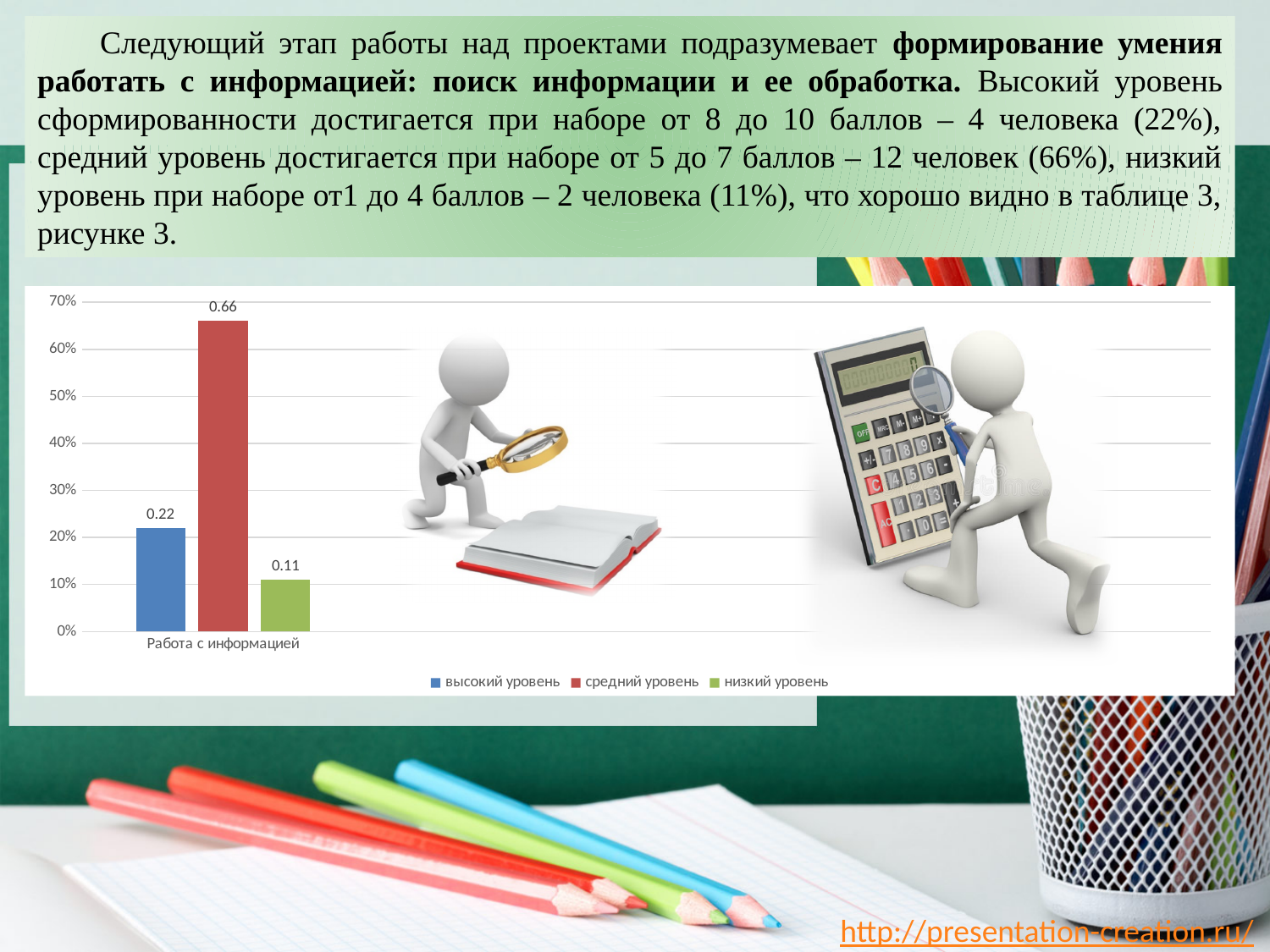
What is the difference between the values for "высокий уровень" and "низкий уровень"? 0.11 Which is larger, the value for "высокий уровень" or the value for "низкий уровень"? высокий уровень What is the difference between the values for "средний уровень" and "высокий уровень"? 0.44 How many series does the legend list? 3 What is the value for the series "высокий уровень"? 0.22 Which series has the highest value? средний уровень What is the value for the series "низкий уровень"? 0.11 What is the value for the series "средний уровень"? 0.66 What is the category label shown on the x axis? Работа с информацией What type of chart is shown on the slide? bar chart Which series has the lowest value? низкий уровень Is the value for "средний уровень" greater or less than 60%? greater